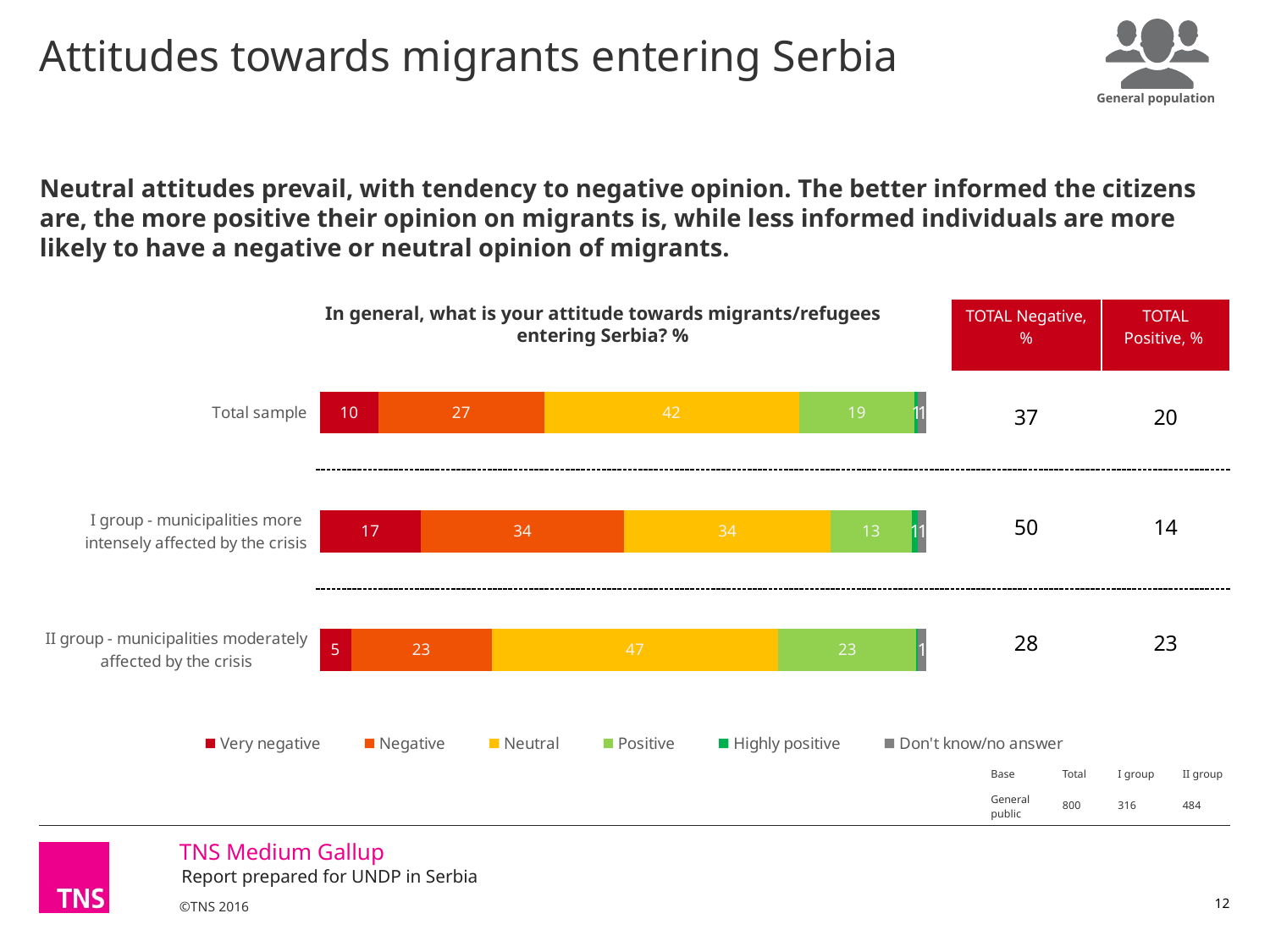
How many groups (bars) are shown in the chart? 3 What is the Negative value for the Total sample? 27 What is the Neutral value for the Total sample? 42 What is the Very negative value for I group - municipalities more intensely affected by the crisis? 17 What is the Positive value for II group - municipalities moderately affected by the crisis? 23 What type of chart is shown on the slide? Stacked bar chart Is the Positive value larger for the Total sample or for I group? Total sample Which group has the lowest Very negative value? II group - municipalities moderately affected by the crisis What is the difference between the Negative values for I group and II group? 11 Which group has the highest Neutral value? II group - municipalities moderately affected by the crisis How many series does the legend list? 6 What colour represents the Neutral series in the chart? Yellow